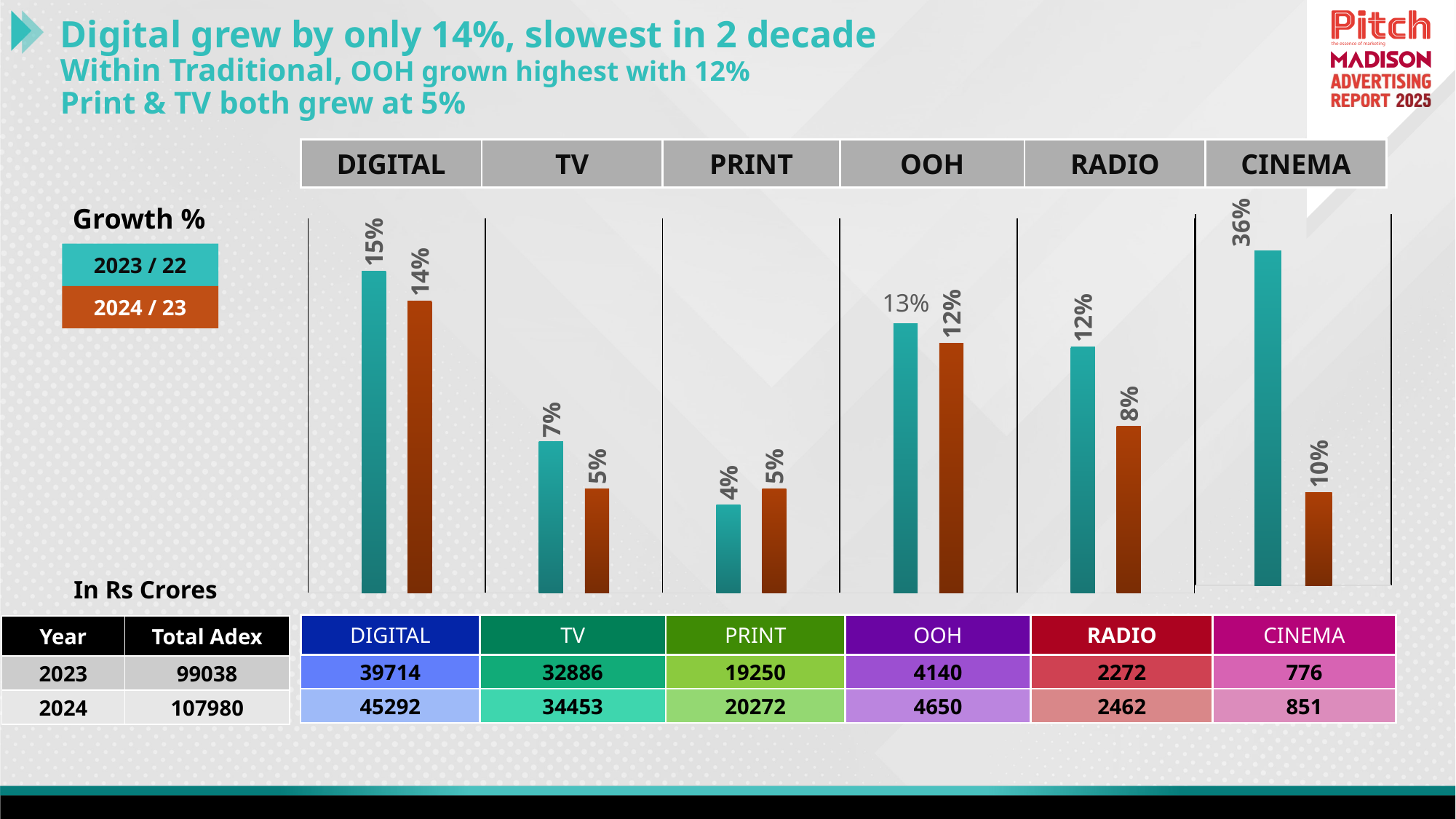
What colour represents the 2024 / 23 series in the chart? Orange Which category has the highest 2023 / 22 growth %? CINEMA Which category has the lowest 2024 / 23 growth %? TV and PRINT (both 5%) Which is larger for OOH: the 2023 / 22 growth % or the 2024 / 23 growth %? 2023 / 22 What kind of chart is used to show growth %? Bar chart What is the 2023 / 22 growth % for PRINT? 4% What is the 2023 / 22 growth % for CINEMA? 36% What is the difference between the 2023 / 22 and 2024 / 23 growth % for CINEMA? 26% How many series does the legend list? 2 How many categories are shown in the growth % chart? 6 What is the 2024 / 23 growth % for DIGITAL? 14% What is the 2024 / 23 growth % for RADIO? 8%